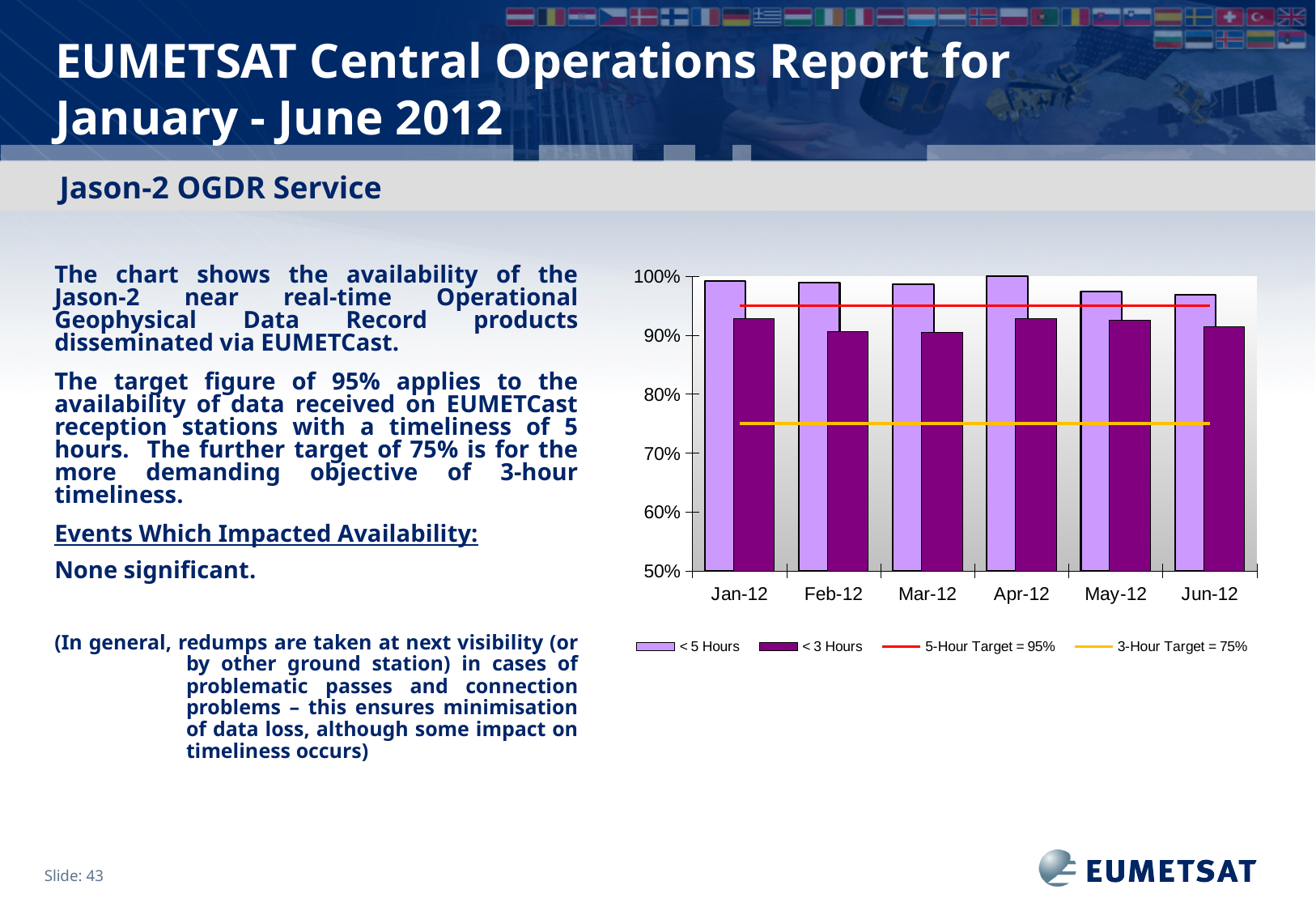
How many months are shown on the x axis of the chart? 6 What value does the legend give for the 5-Hour Target line? 95% Is the < 5 Hours value for Jun-12 greater or less than 95%? greater Is the < 3 Hours value for Feb-12 greater or less than 95%? less Is the < 3 Hours value for Jan-12 greater or less than 95%? less What type of chart is shown on the slide? bar chart In Jan-12, which series has the larger value, < 5 Hours or < 3 Hours? < 5 Hours What value does the legend give for the 3-Hour Target line? 75% How many entries does the chart legend list? 4 In Mar-12, which series has the larger value, < 5 Hours or < 3 Hours? < 5 Hours